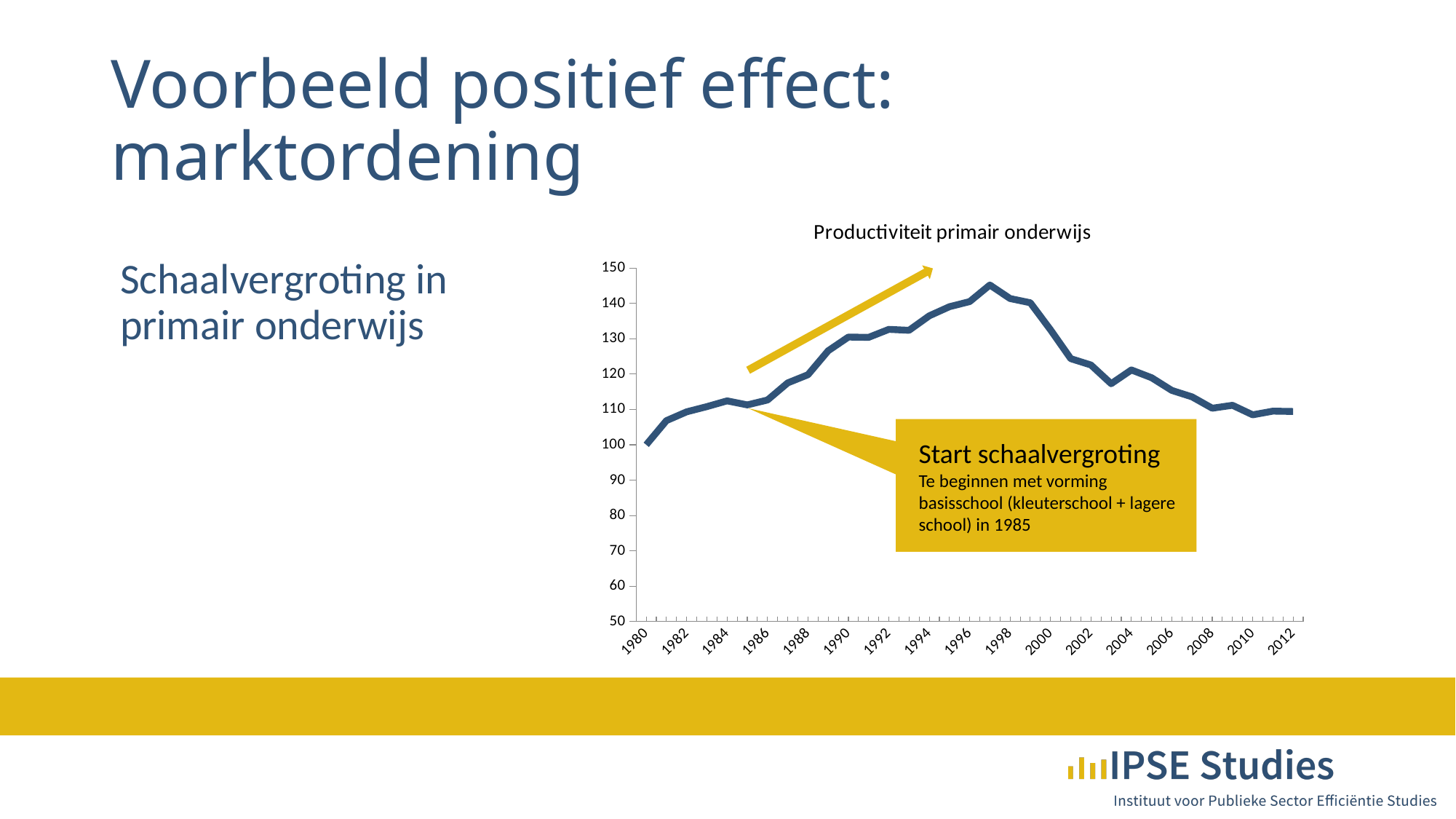
In which year does the productivity line reach its highest point? 1997 Is the value for 1994 greater or less than 130? greater Is the value for 1997 greater or less than 140? greater Is the value for 1986 greater or less than 110? greater Which year has the higher productivity value, 1990 or 2010? 1990 Does the productivity line rise or fall between 1997 and 2012? fall What kind of chart is shown on the slide? line chart What is the productivity value in 1980? 100 What is the title of the chart? Productiviteit primair onderwijs In which year is the productivity value lowest? 1980 According to the annotation on the chart, in which year did the schaalvergroting start? 1985